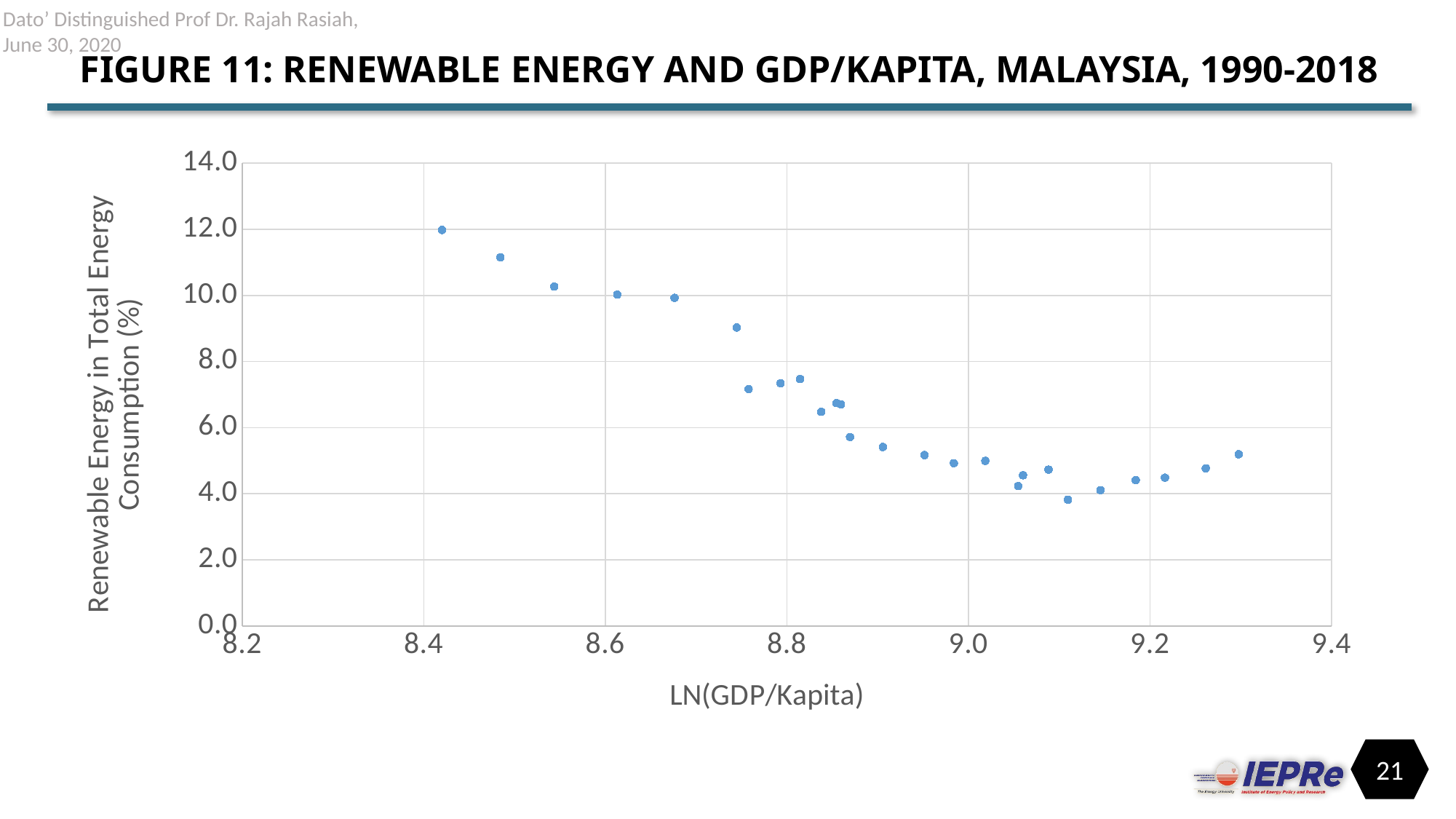
What kind of chart is shown on the slide? Scatter plot Is the highest plotted value found at the left end or the right end of the x axis? Left end Is the value for the point near LN(GDP/Kapita) 8.5 greater or less than 10.0? greater Is the lowest plotted value of renewable energy share greater or less than 6.0? less Which has the larger renewable energy share: the leftmost point (near 8.4) or the rightmost point (near 9.3)? The leftmost point (near 8.4) Which has the larger renewable energy share: the point near LN(GDP/Kapita) 8.6 or the point near 9.0? The point near 8.6 What is the title of the chart? FIGURE 11: RENEWABLE ENERGY AND GDP/KAPITA, MALAYSIA, 1990-2018 Is the highest plotted value of renewable energy share greater or less than 10.0? greater Overall, do the plotted values rise or fall as LN(GDP/Kapita) increases from 8.4 to 9.1? Fall What is the label of the x axis? LN(GDP/Kapita)